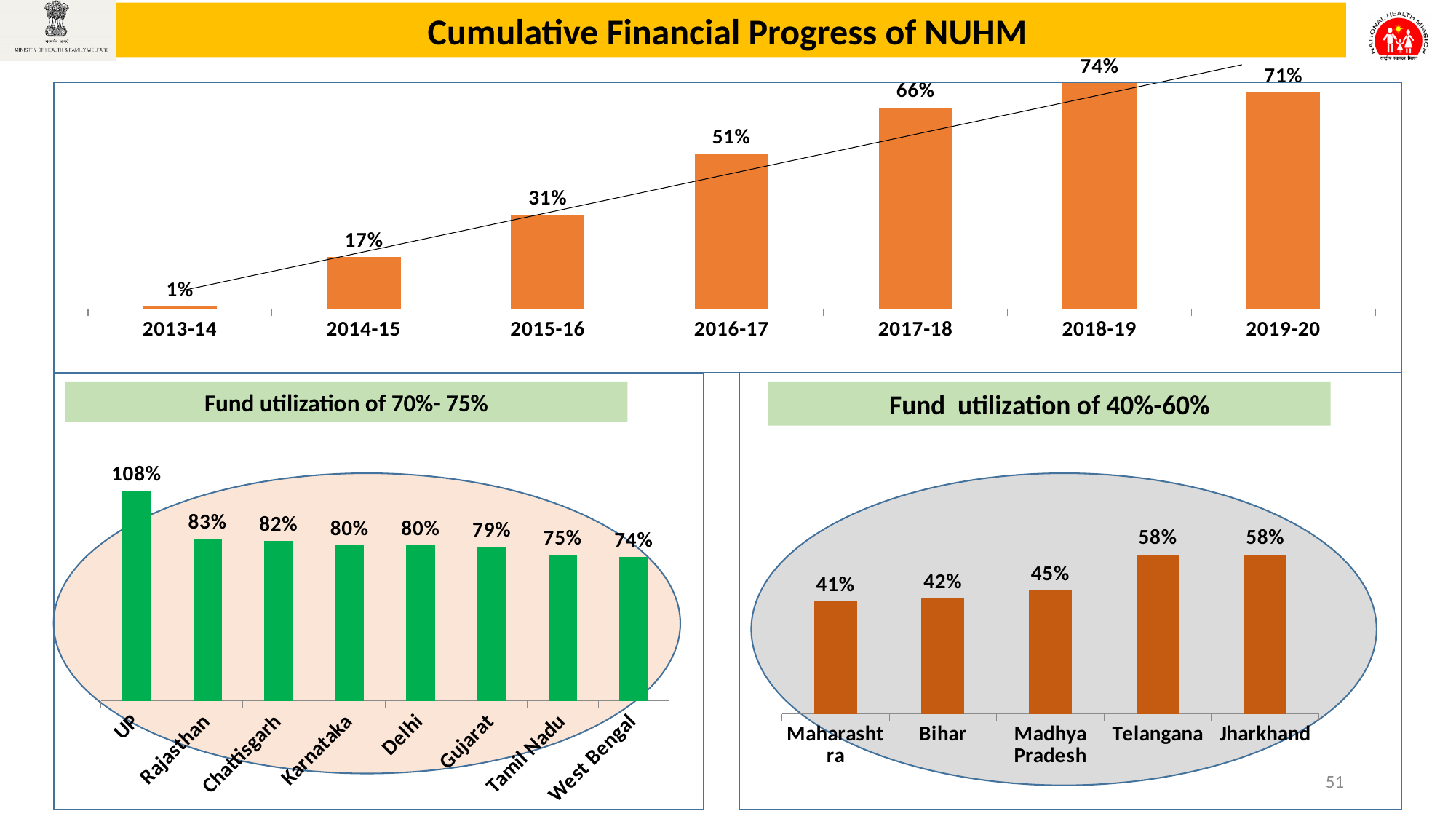
In the bottom-left chart (Fund utilization of 70%-75%), which is larger, the value for Rajasthan or the value for West Bengal? Rajasthan What kind of chart is the bottom-right chart (Fund utilization of 40%-60%)? Bar chart In the top chart (Cumulative Financial Progress of NUHM), what is the difference between the values for 2016-17 and 2015-16? 20% In the bottom-right chart (Fund utilization of 40%-60%), which state has the lowest value? Maharashtra In the bottom-left chart (Fund utilization of 70%-75%), which state has the highest value? UP In the top chart (Cumulative Financial Progress of NUHM), how many years are shown on the x axis? 7 In the top chart (Cumulative Financial Progress of NUHM), which year has the lowest value? 2013-14 In the bottom-right chart (Fund utilization of 40%-60%), what is the value for Madhya Pradesh? 45% In the bottom-left chart (Fund utilization of 70%-75%), how many states are shown? 8 In the top chart (Cumulative Financial Progress of NUHM), which year has the highest value? 2018-19 In the top chart (Cumulative Financial Progress of NUHM), what is the value for 2017-18? 66% In the bottom-left chart (Fund utilization of 70%-75%), what is the value for Gujarat? 79%